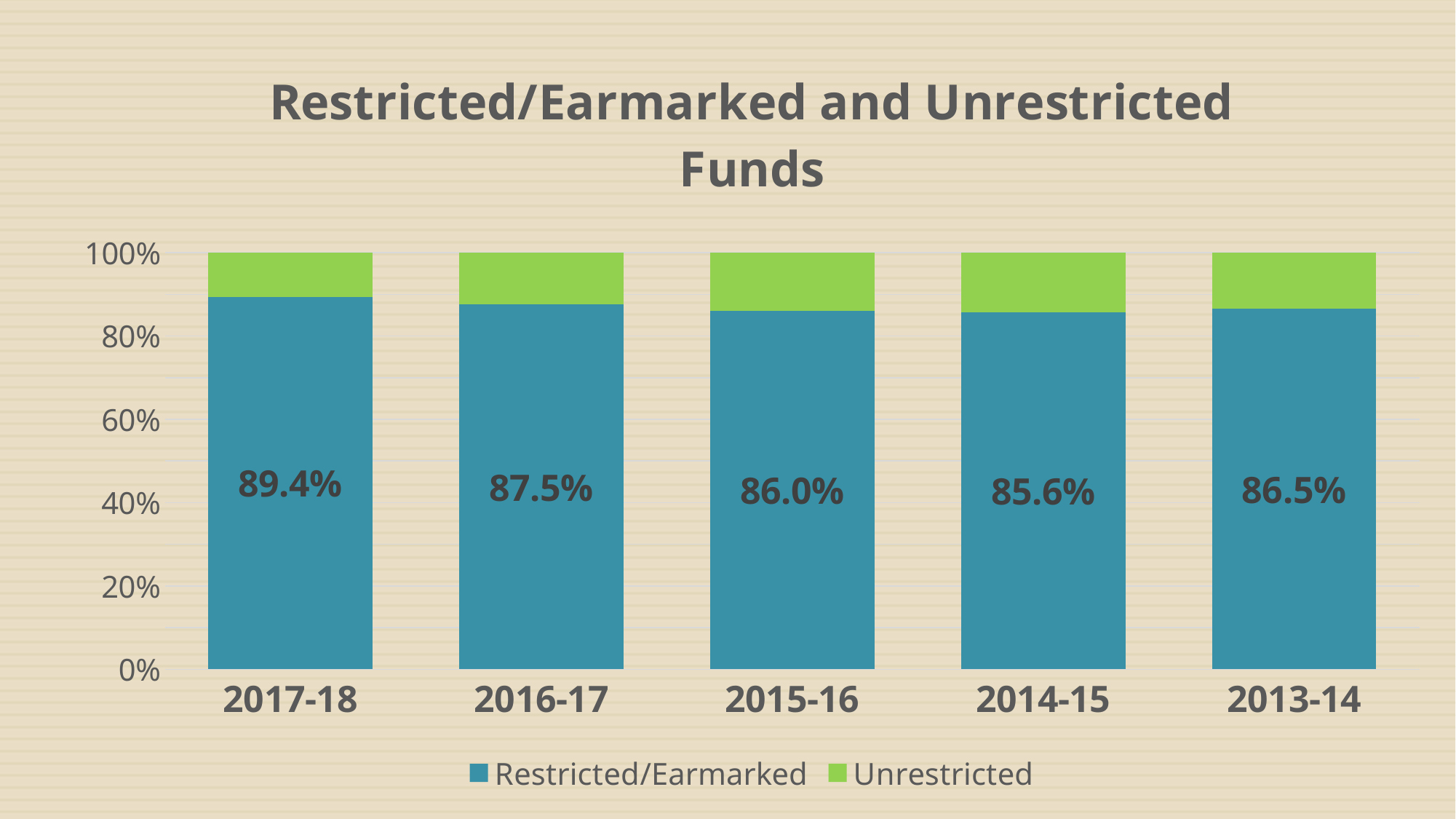
Is the Restricted/Earmarked value for 2015-16 greater or less than 80%? greater What is the Restricted/Earmarked value for 2017-18? 89.4% What is the difference between the Restricted/Earmarked values for 2017-18 and 2014-15? 3.8 percentage points Which is larger, the Restricted/Earmarked value for 2016-17 or for 2013-14? 2016-17 Which year has the highest Restricted/Earmarked share? 2017-18 How many series does the legend list? 2 What is the Restricted/Earmarked value for 2014-15? 85.6% How many years are shown on the x axis? 5 Which year has the lowest Restricted/Earmarked share? 2014-15 What is the Restricted/Earmarked value for 2013-14? 86.5% What kind of chart is shown on the slide? Stacked bar chart Does the Restricted/Earmarked value rise or fall from 2017-18 to 2015-16? fall